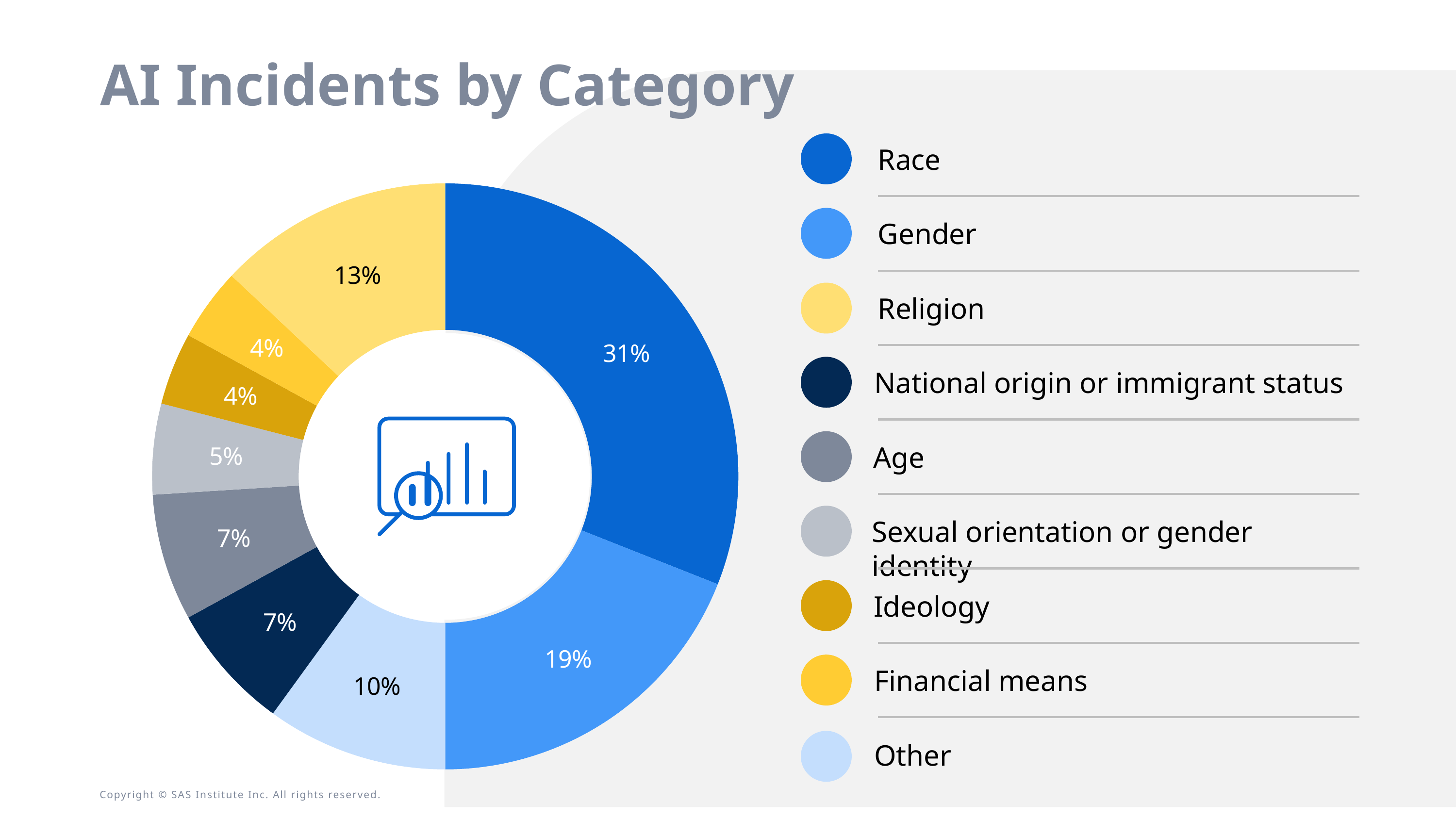
Which category accounts for the largest share of AI incidents? Race What share of AI incidents falls under Religion? 13% How many percentage points larger is the Race share than the Gender share? 12% What percentage of AI incidents is attributed to Gender? 19% How many categories are shown in the chart? 9 What is the title of the chart on this slide? AI Incidents by Category What percentage is shown for Sexual orientation or gender identity? 5% What percentage is shown for the Other category? 10% Which has a larger share of AI incidents, Religion or Other? Religion What percentage of AI incidents is attributed to Race? 31% What type of chart is used on this slide? Doughnut chart Which has a larger share, Age or Sexual orientation or gender identity? Age